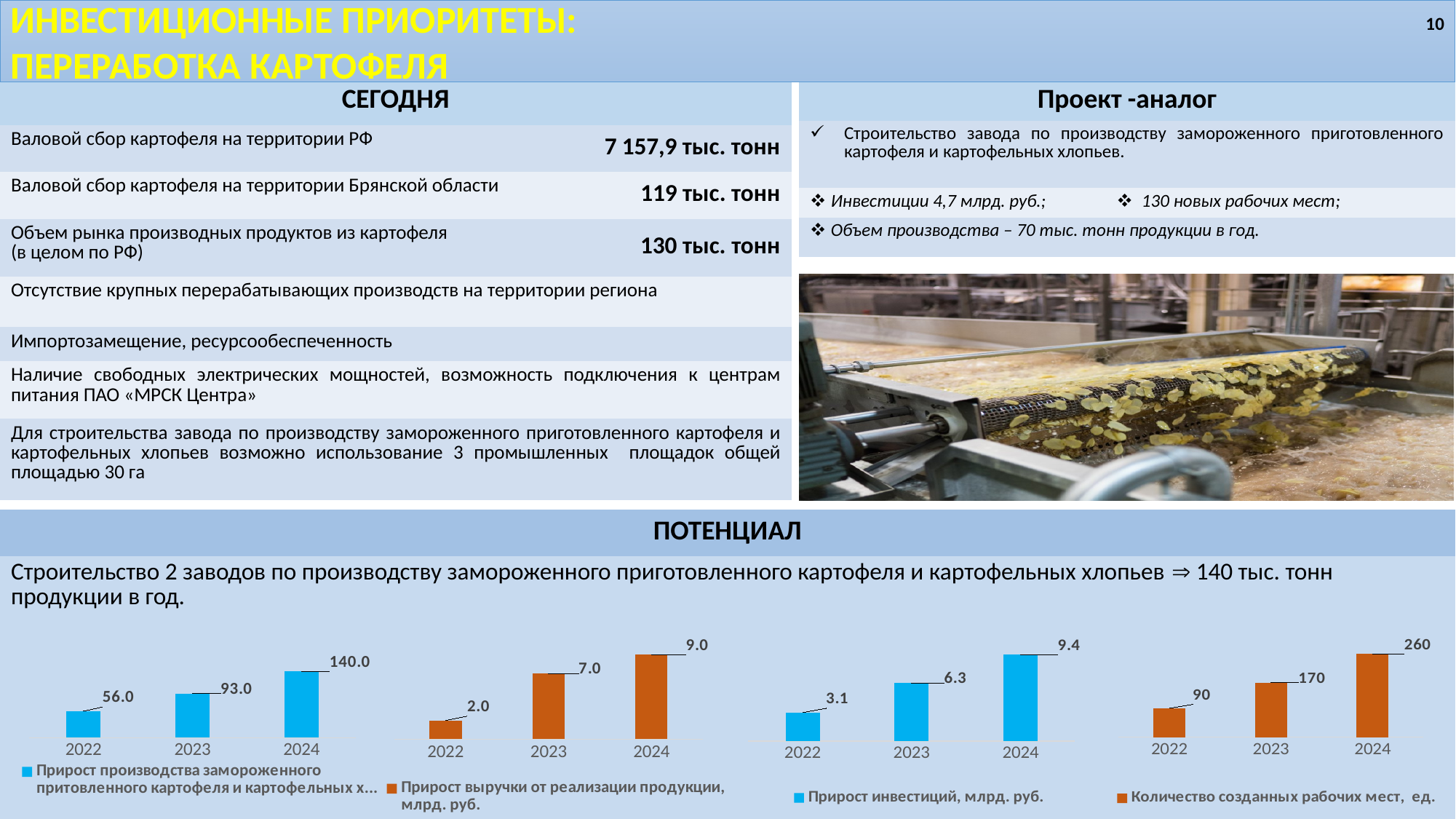
In the leftmost chart at the bottom of the slide (Прирост производства), do the values rise or fall from 2022 to 2024? rise In the chart titled 'Количество созданных рабочих мест, ед.', which year has the highest value? 2024 In the chart titled 'Прирост инвестиций, млрд. руб.', what is the value for 2024? 9.4 How many years (categories) are shown in the chart titled 'Прирост выручки от реализации продукции, млрд. руб.'? 3 In the chart titled 'Прирост инвестиций, млрд. руб.', what is the difference between the 2024 and 2022 values? 6.3 In the leftmost chart at the bottom of the slide (Прирост производства замороженного приготовленного картофеля), what is the value for 2024? 140.0 In the chart titled 'Количество созданных рабочих мест, ед.', what is the value for 2023? 170 In the chart titled 'Прирост выручки от реализации продукции, млрд. руб.', what is the value for 2023? 7.0 In the chart titled 'Прирост выручки от реализации продукции, млрд. руб.', which year has the lowest value? 2022 What type of chart is the chart titled 'Прирост инвестиций, млрд. руб.'? bar chart In the chart titled 'Количество созданных рабочих мест, ед.', what is the difference between the 2024 and 2023 values? 90 In the leftmost chart at the bottom of the slide (Прирост производства), what is the value for 2022? 56.0